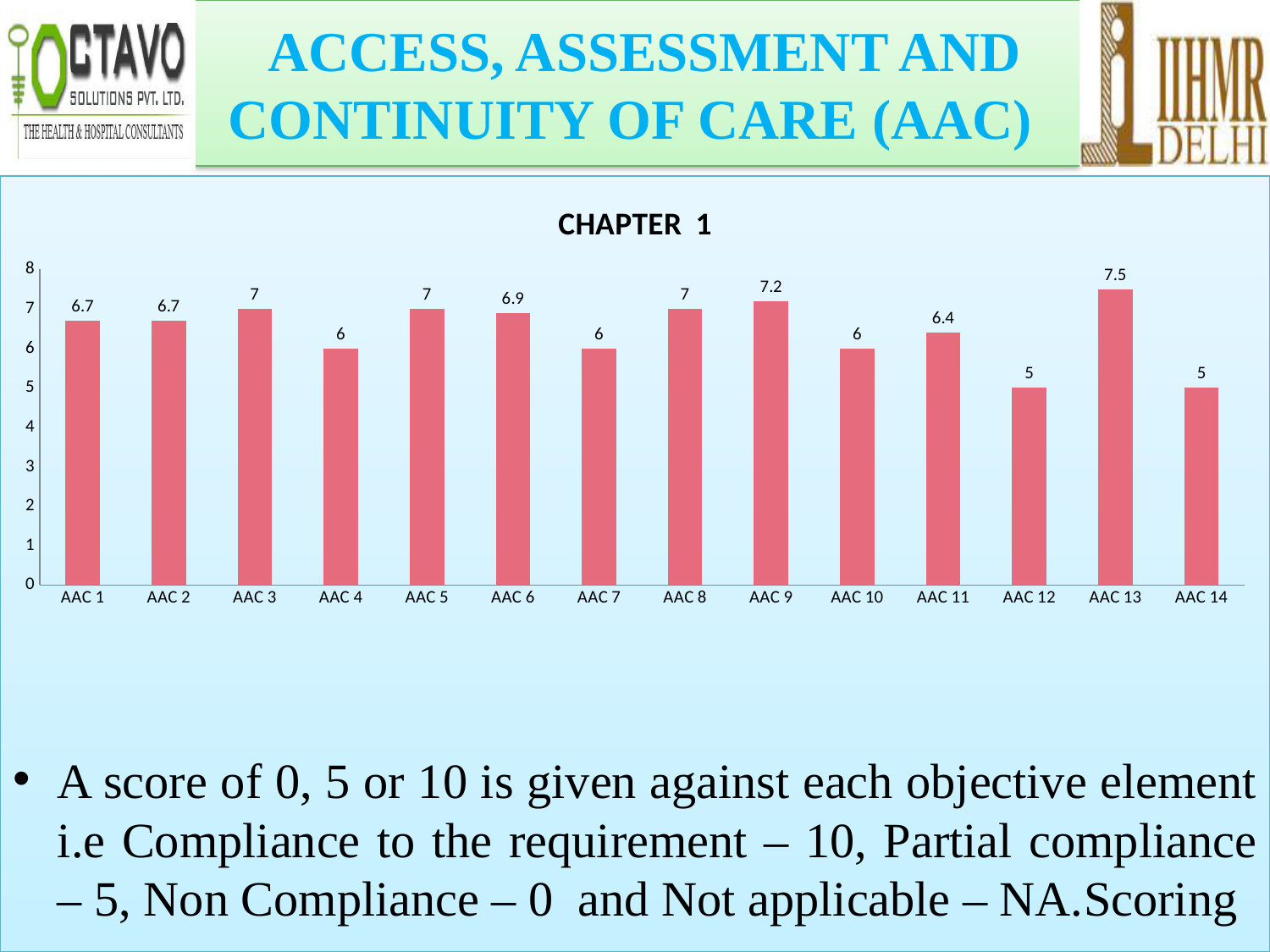
How many categories are shown on the x axis? 14 Which category has the highest value? AAC 13 What is the difference between the values for AAC 9 and AAC 4? 1.2 What is the value for AAC 11? 6.4 What is the value for AAC 6? 6.9 What kind of chart is shown on the slide? Bar chart What is the value for AAC 9? 7.2 Which is larger, the value for AAC 3 or the value for AAC 11? AAC 3 What is the maximum value shown on the y axis? 8 Is the value for AAC 13 greater or less than 7? greater What is the title of the chart? CHAPTER 1 What is the difference between the values for AAC 13 and AAC 12? 2.5